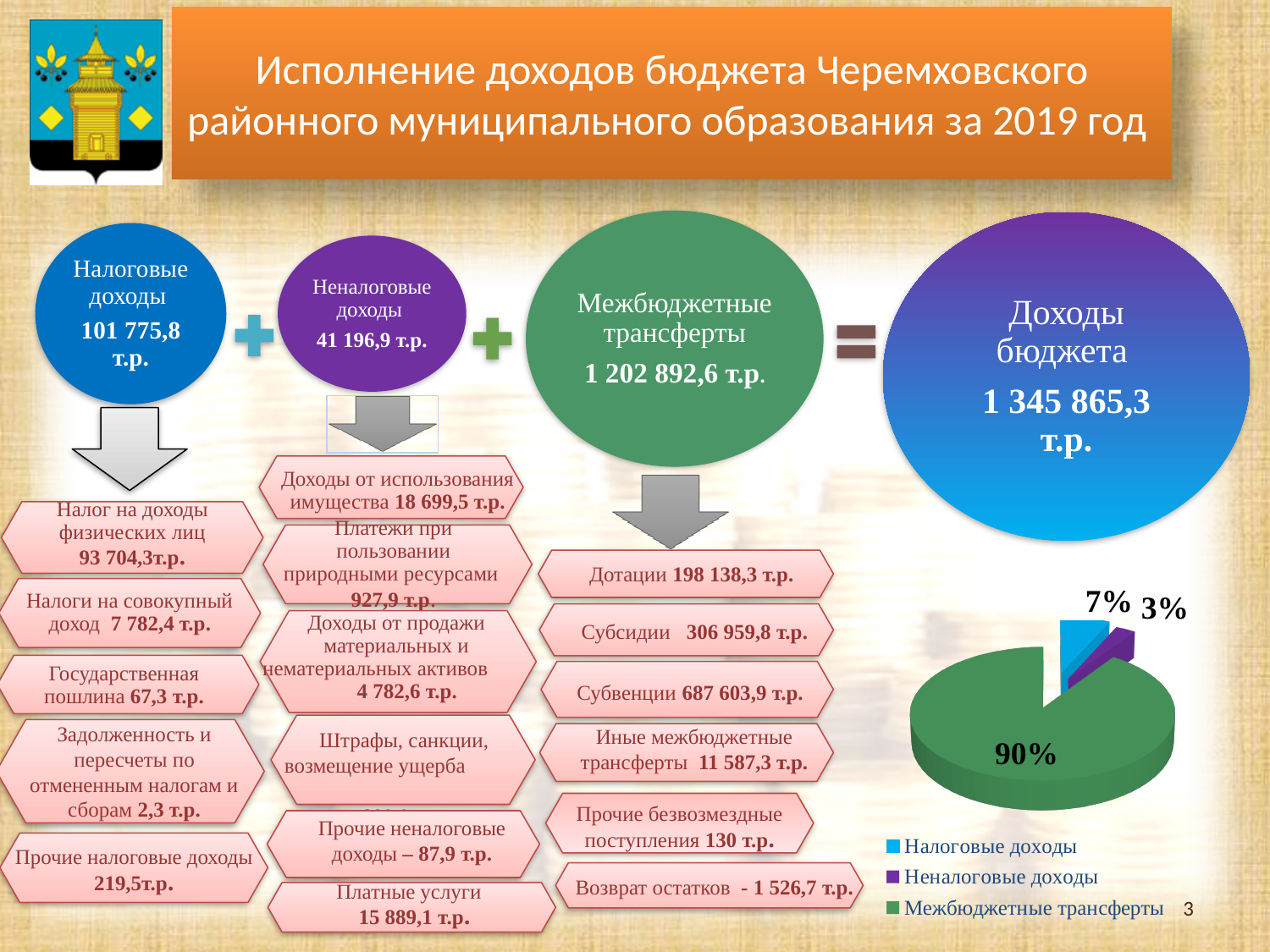
What kind of chart is shown in the lower right of the slide? pie chart Which category has the largest slice in the pie chart? Межбюджетные трансферты In the pie chart, which is larger: the share for Налоговые доходы or the share for Неналоговые доходы? Налоговые доходы In the pie chart, what is the difference in percentage points between the share for Межбюджетные трансферты and the share for Налоговые доходы? 83 How many slices does the pie chart have? 3 Which category has the smallest slice in the pie chart? Неналоговые доходы In the pie chart, what share is shown for Неналоговые доходы? 3% In the pie chart, what share is shown for Межбюджетные трансферты? 90% In the pie chart, what share is shown for Налоговые доходы? 7% What colour is the slice for Межбюджетные трансферты in the pie chart? green How many entries does the pie chart legend list? 3 In the pie chart, what is the difference in percentage points between the share for Налоговые доходы and the share for Неналоговые доходы? 4